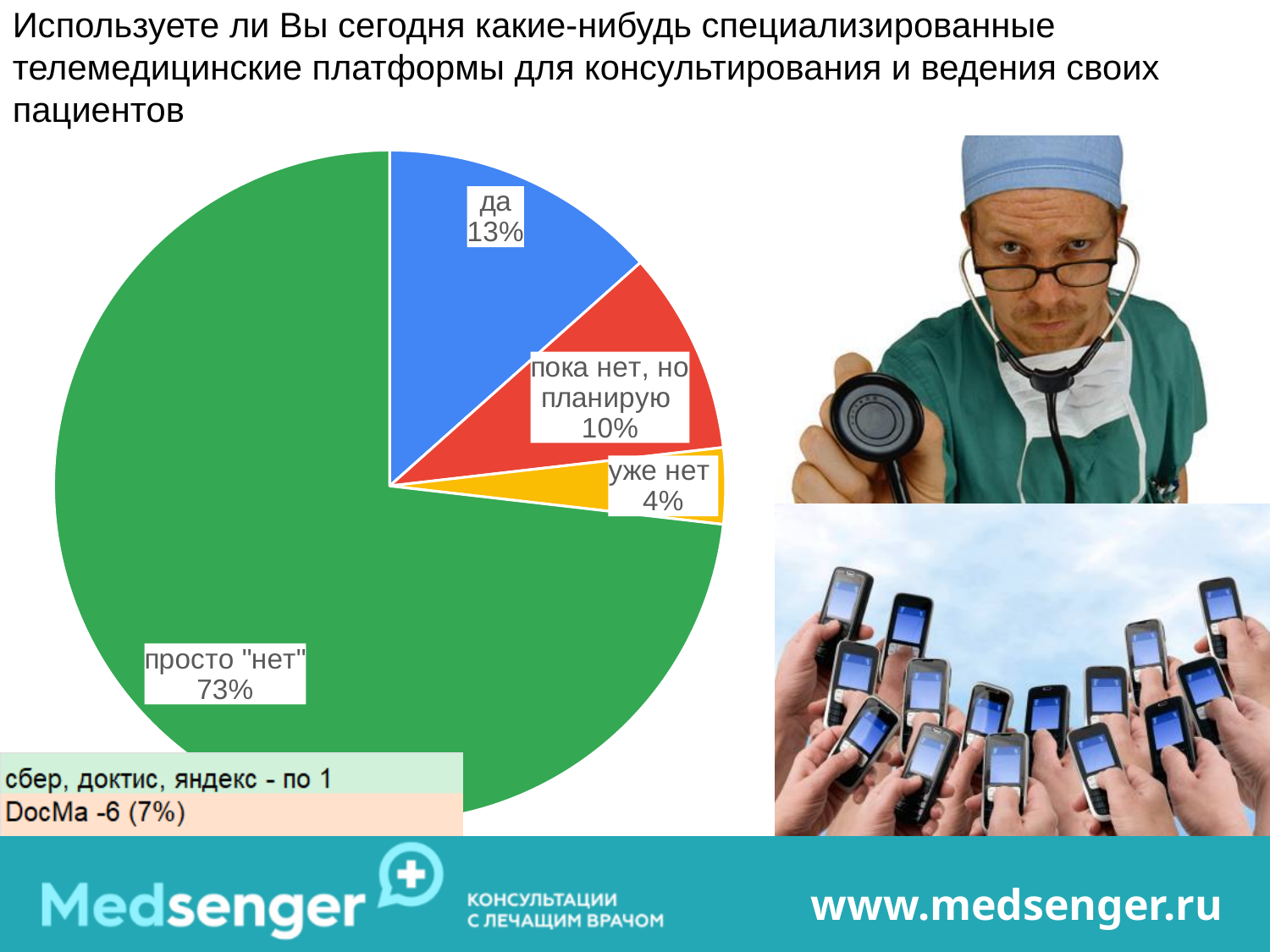
Which slice is larger: "да" or "уже нет"? да What share of respondents answered "просто "нет""? 73% What colour is the "просто "нет"" slice of the pie chart? green Which answer has the largest slice of the pie chart? просто "нет" How many slices does the pie chart have? 4 What is the difference in percentage points between "да" and "пока нет, но планирую"? 3 What is the difference in percentage points between "просто "нет"" and "да"? 60 What type of chart is shown on the slide? pie chart Which answer has the smallest slice of the pie chart? уже нет What share of respondents answered "да" in the pie chart? 13% What share of respondents answered "пока нет, но планирую"? 10% What share of respondents answered "уже нет"? 4%